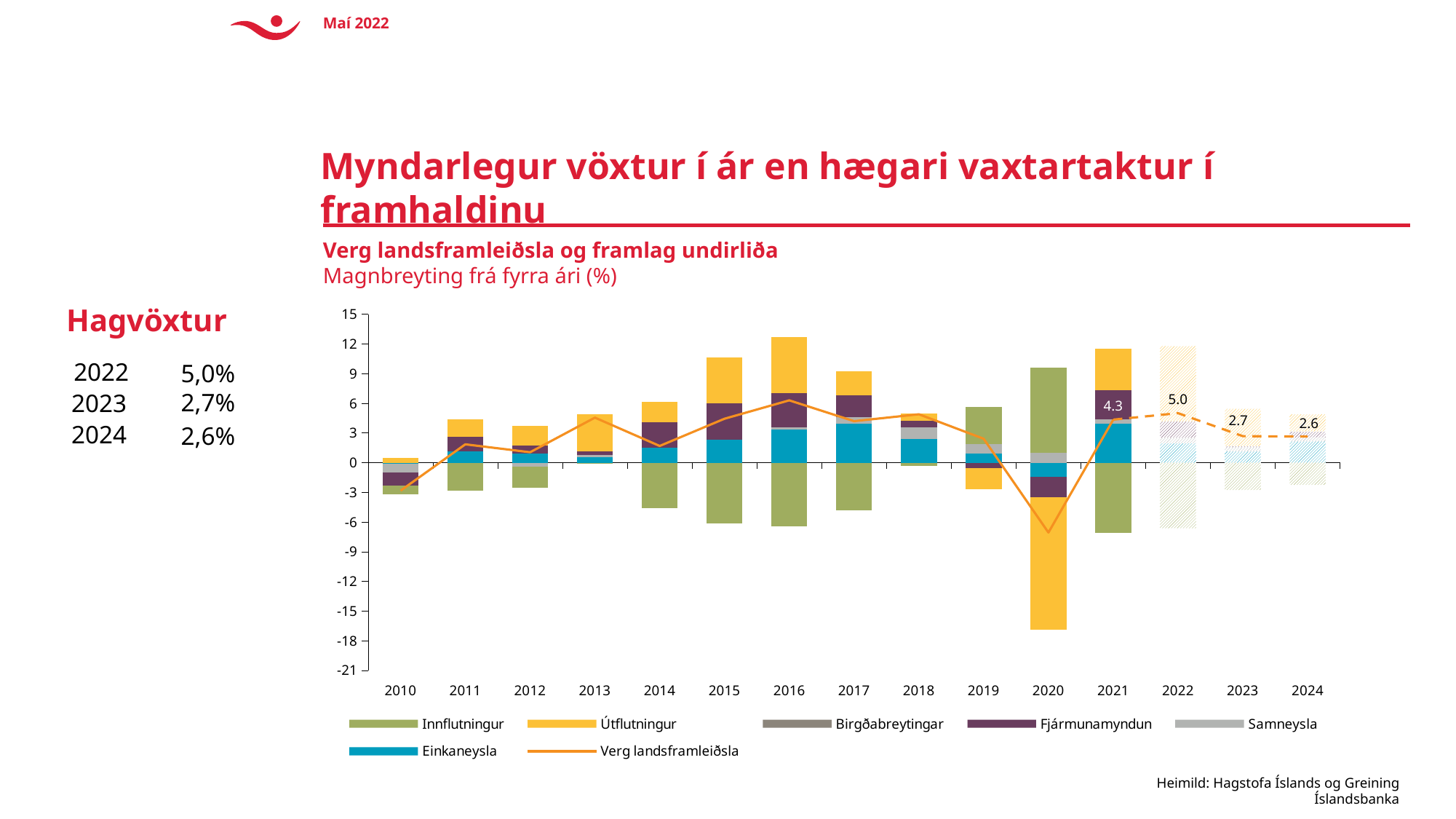
In which year is the Verg landsframleiðsla line at its lowest? 2020 What is the value of Verg landsframleiðsla for 2022? 5.0 What is the value of Verg landsframleiðsla for 2024? 2.6 How many series does the legend list? 7 Is the Verg landsframleiðsla value for 2020 greater or less than -3? less How many years are shown on the x axis? 15 Is the Útflutningur value for 2020 greater or less than -15? greater What is the difference between the Verg landsframleiðsla values for 2022 and 2023? 2.3 Which year has the larger Verg landsframleiðsla value, 2022 or 2024? 2022 Does the Verg landsframleiðsla line rise or fall from 2022 to 2024? Fall What is the value of Verg landsframleiðsla for 2021? 4.3 What kind of chart is shown on the slide? Stacked bar chart with a line